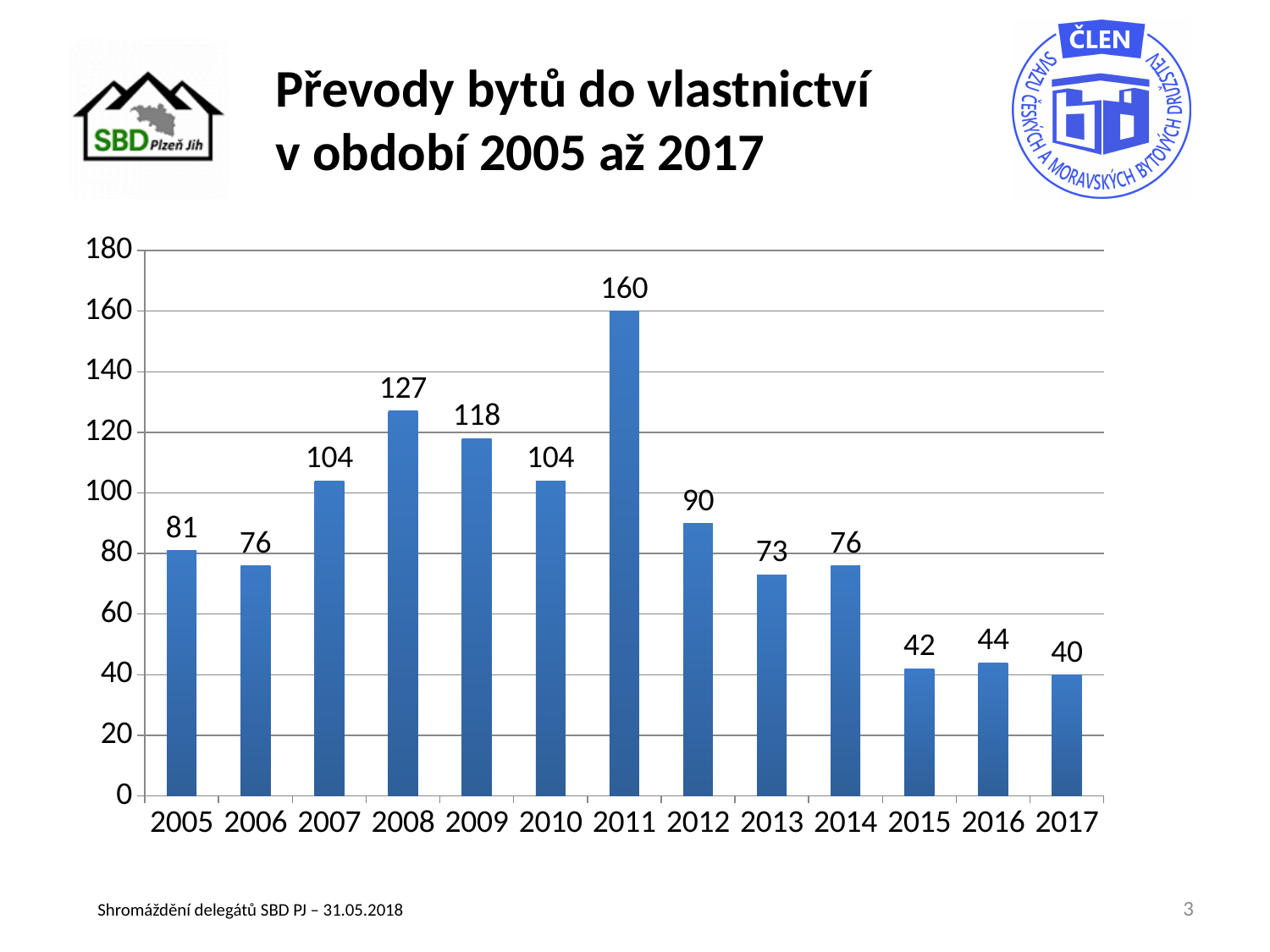
What is the value for 2017? 40 Which is larger, the value for 2007 or the value for 2013? 2007 What kind of chart is shown on the slide? bar chart Do the values rise or fall from 2011 to 2017? fall What is the value for 2011? 160 How many years are shown on the x axis? 13 Which year has the highest value? 2011 Which year has the lowest value? 2017 What is the difference between the values for 2008 and 2009? 9 What is the value for 2005? 81 Is the value for 2008 greater or less than 120? greater What is the difference between the values for 2011 and 2012? 70